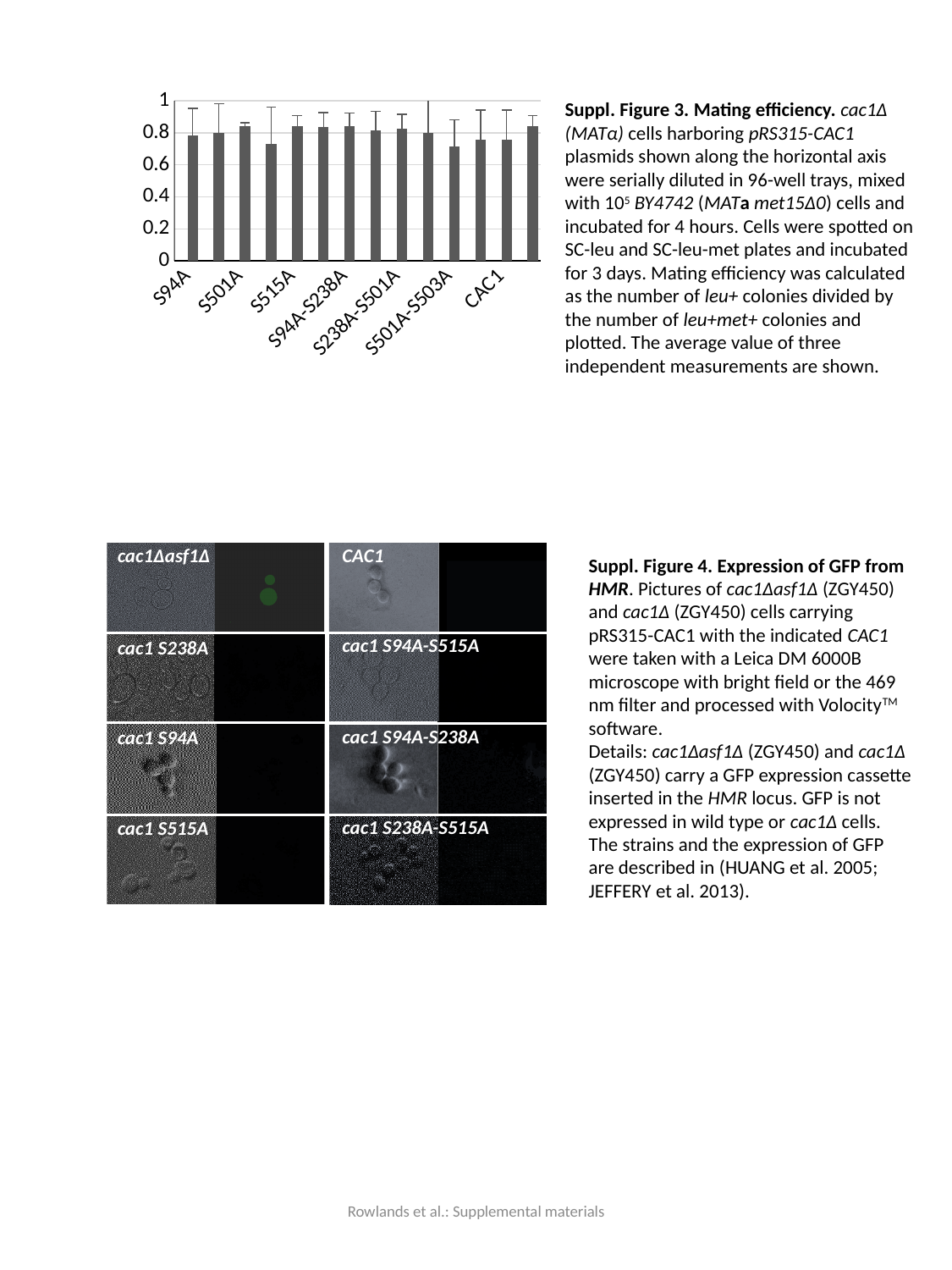
According to the caption, what quantity does the Suppl. Figure 3 bar chart plot? Mating efficiency What kind of chart is shown in Suppl. Figure 3? bar chart In the Suppl. Figure 3 bar chart, is the value for CAC1 greater or less than 1? less In the Suppl. Figure 3 bar chart, is the value for S501A-S503A greater or less than 0.2? greater How many bars are plotted in the Suppl. Figure 3 bar chart? 14 In the Suppl. Figure 3 bar chart, is the value for S94A greater or less than 0.6? greater What is the highest tick value shown on the y axis of the Suppl. Figure 3 bar chart? 1